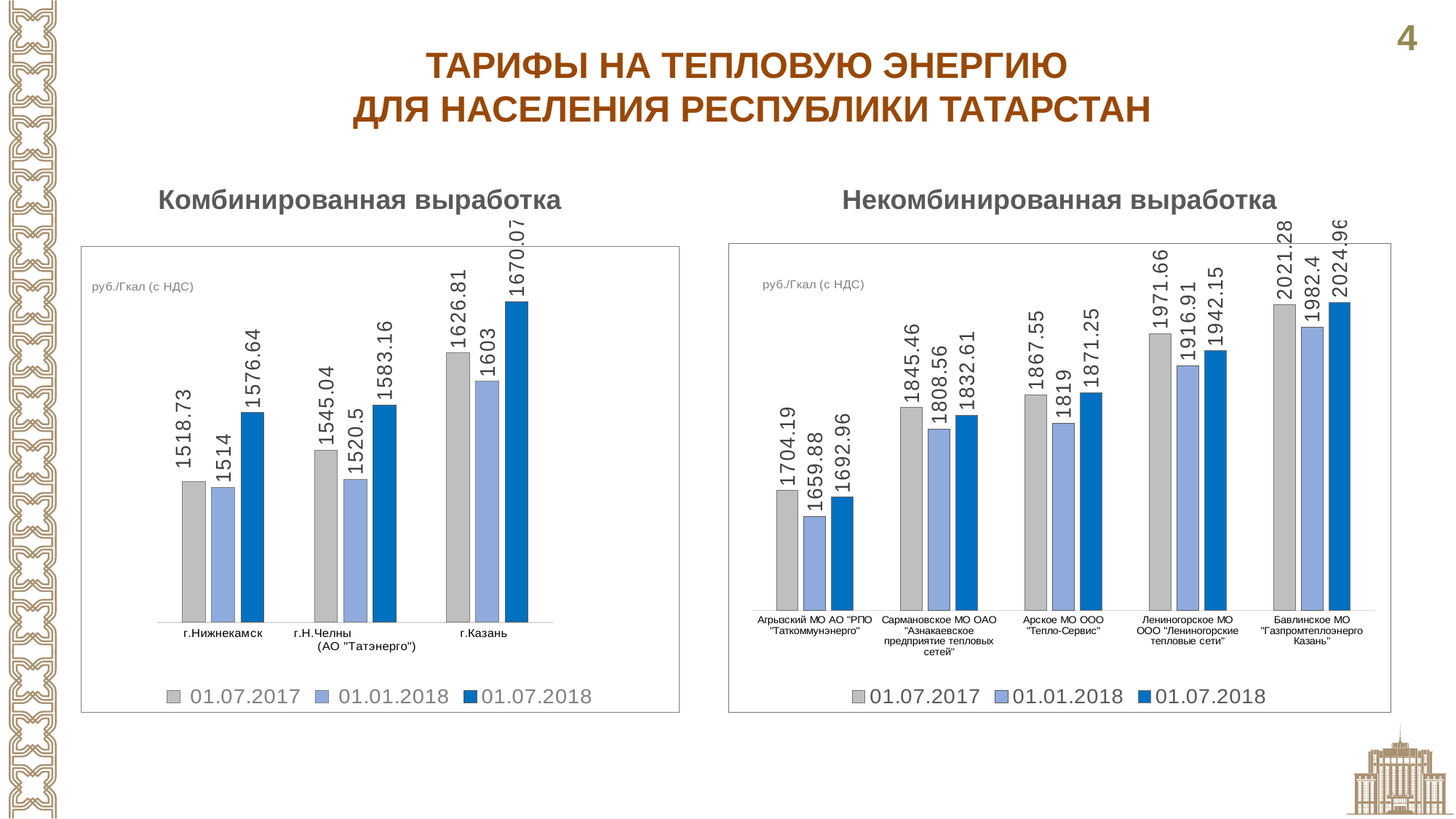
In the chart titled "Комбинированная выработка", what is the difference between the 01.07.2018 and 01.07.2017 values for г.Казань? 43.26 In the chart titled "Некомбинированная выработка", which category has the highest value for 01.07.2018? Бавлинское МО "Газпромтеплоэнерго Казань" What kind of chart is the chart titled "Комбинированная выработка"? Bar chart In the chart titled "Комбинированная выработка", which category has the lowest value for 01.01.2018? г.Нижнекамск How many series does the legend list in the chart titled "Комбинированная выработка"? 3 How many categories are shown in the chart titled "Некомбинированная выработка"? 5 In the chart titled "Комбинированная выработка", what is the value for г.Н.Челны (АО "Татэнерго") for 01.07.2017? 1545.04 In the chart titled "Некомбинированная выработка", what is the value for Арское МО ООО "Тепло-Сервис" for 01.01.2018? 1819 In the chart titled "Некомбинированная выработка", what unit is indicated in the top-left corner of the plot area? руб./Гкал (с НДС) In the chart titled "Некомбинированная выработка", which is larger for Агрызский МО АО "РПО "Таткоммунэнерго": the 01.07.2017 value or the 01.07.2018 value? 01.07.2017 In the chart titled "Комбинированная выработка", what is the value for г.Казань for 01.07.2018? 1670.07 In the chart titled "Некомбинированная выработка", what is the difference between the 01.07.2018 and 01.01.2018 values for Бавлинское МО "Газпромтеплоэнерго Казань"? 42.56